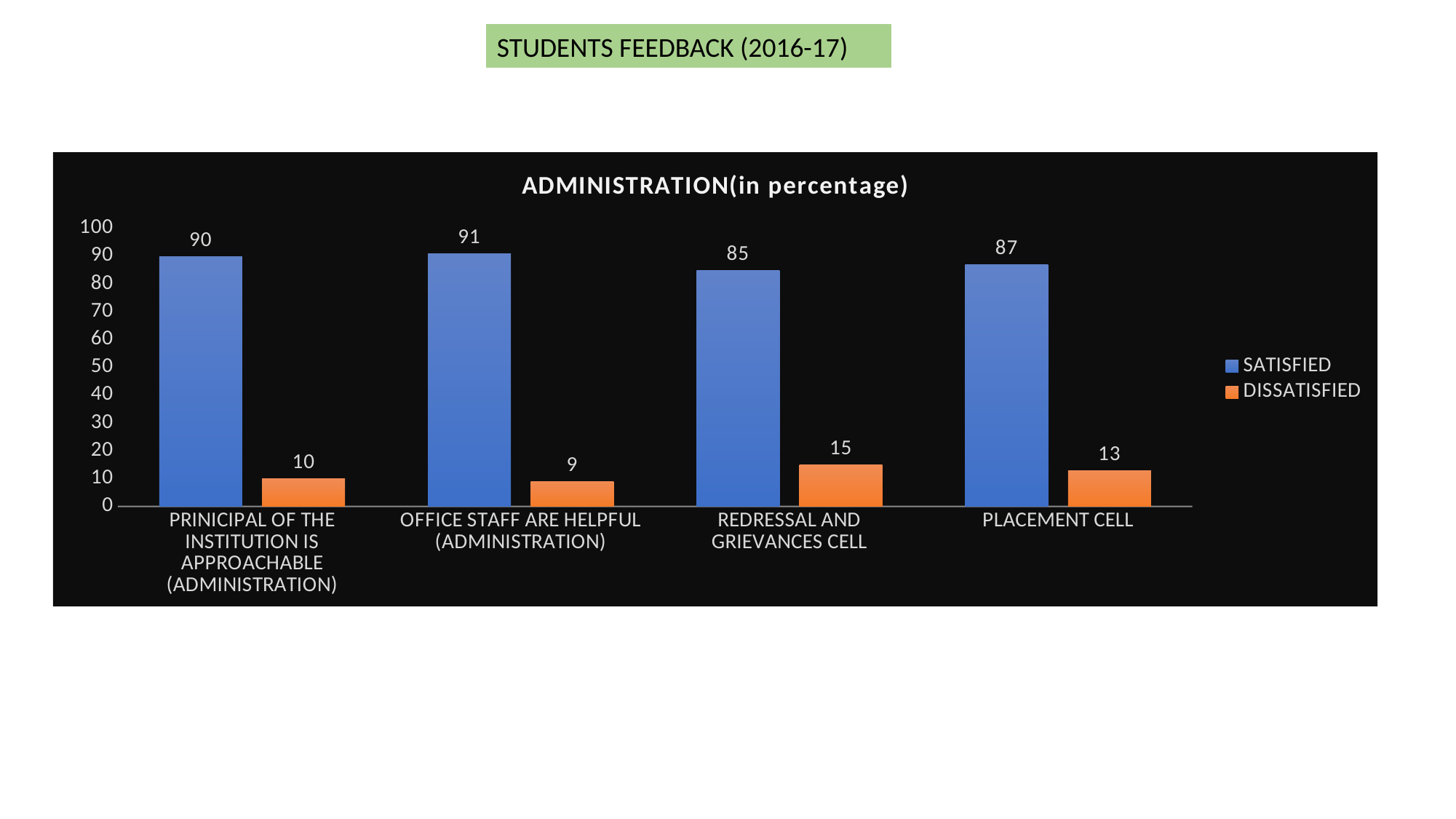
Which is larger: the SATISFIED value for REDRESSAL AND GRIEVANCES CELL or the SATISFIED value for PLACEMENT CELL? PLACEMENT CELL Is the DISSATISFIED value for PLACEMENT CELL greater or less than 20? less What is the SATISFIED value for OFFICE STAFF ARE HELPFUL (ADMINISTRATION)? 91 Which category has the lowest DISSATISFIED value? OFFICE STAFF ARE HELPFUL (ADMINISTRATION) Which category has the highest SATISFIED value? OFFICE STAFF ARE HELPFUL (ADMINISTRATION) How many categories are shown on the x axis? 4 What is the DISSATISFIED value for REDRESSAL AND GRIEVANCES CELL? 15 What is the SATISFIED value for PLACEMENT CELL? 87 What kind of chart is shown? bar chart What is the difference between the SATISFIED and DISSATISFIED values for PRINCIPAL OF THE INSTITUTION IS APPROACHABLE (ADMINISTRATION)? 80 How many series does the legend list? 2 What is the title of the chart? ADMINISTRATION(in percentage)